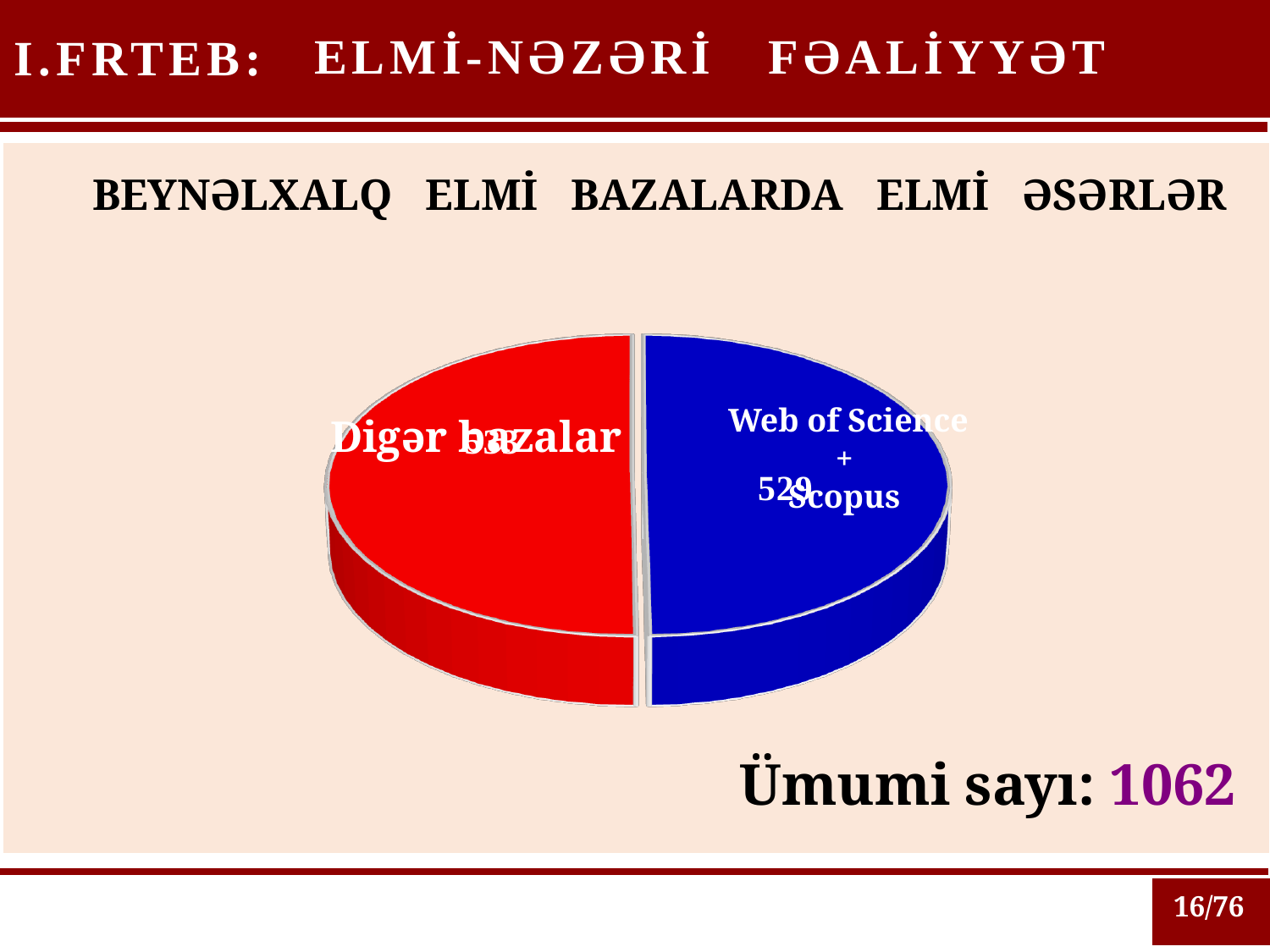
What kind of chart is shown on the slide? pie chart What is the title of the chart on the slide? BEYNƏLXALQ ELMİ BAZALARDA ELMİ ƏSƏRLƏR What total number (Ümumi sayı) is shown below the pie chart? 1062 What colour is the Web of Science + Scopus slice? blue How many slices does the pie chart have? 2 What is the value shown for the Web of Science + Scopus slice? 529 Which slice is coloured red? Digər bazalar